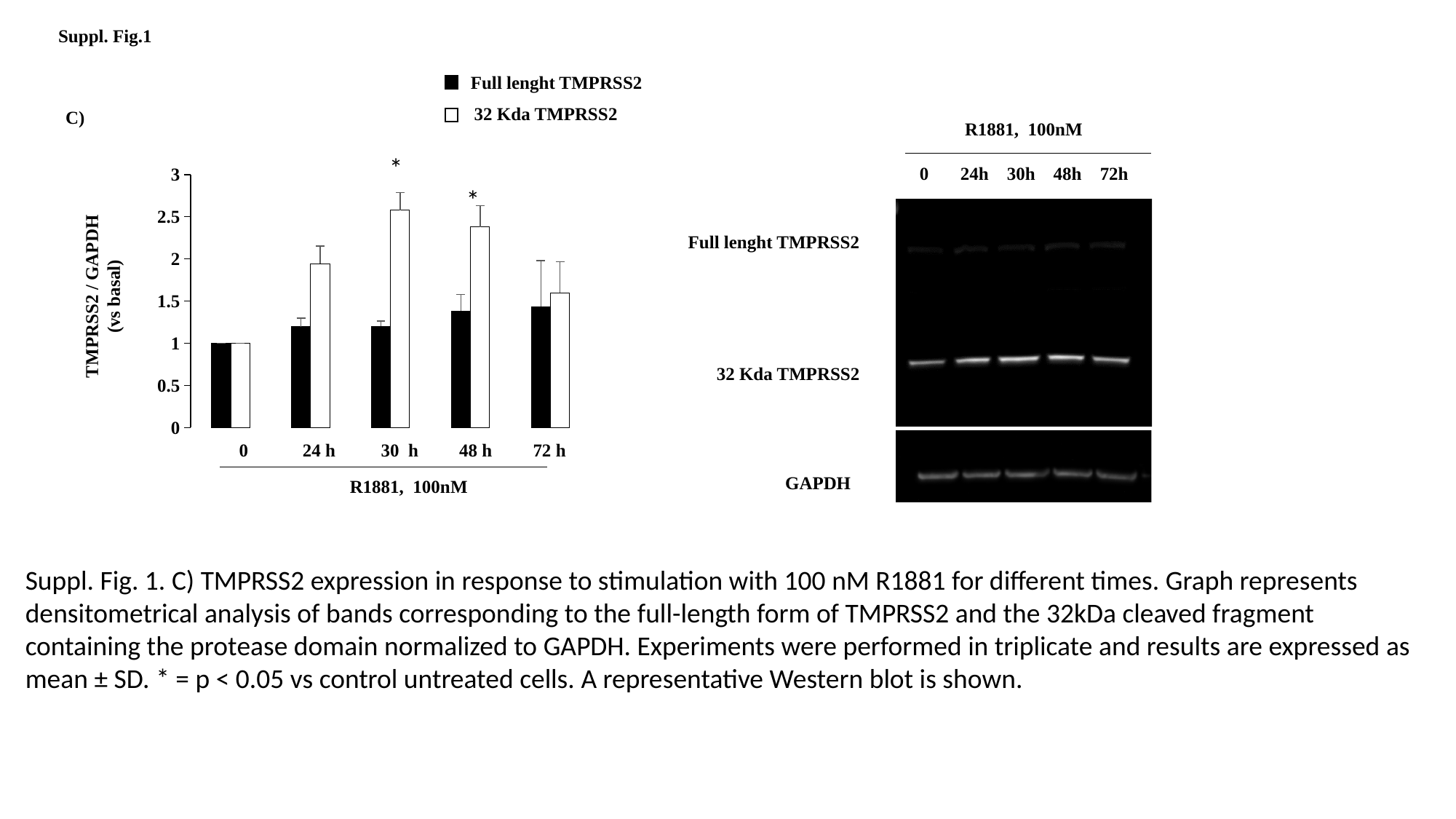
What is the value of Full lenght TMPRSS2 at time 0? 1 How many series does the chart legend list? 2 Is the value for 32 Kda TMPRSS2 at 30 h greater or less than 2? greater What is the label of the y axis of the bar chart? TMPRSS2 / GAPDH (vs basal) At which time point is the 32 Kda TMPRSS2 value highest? 30 h At 24 h, which series has the larger value, Full lenght TMPRSS2 or 32 Kda TMPRSS2? 32 Kda TMPRSS2 Does the Full lenght TMPRSS2 value rise or fall from 0 to 72 h? rise What is the value of 32 Kda TMPRSS2 at time 0? 1 Is the value for Full lenght TMPRSS2 at 48 h greater or less than 1.5? less How many time-point categories are shown on the x axis of the bar chart? 5 What kind of chart is shown on the slide? bar chart At which time point is the 32 Kda TMPRSS2 value lowest? 0